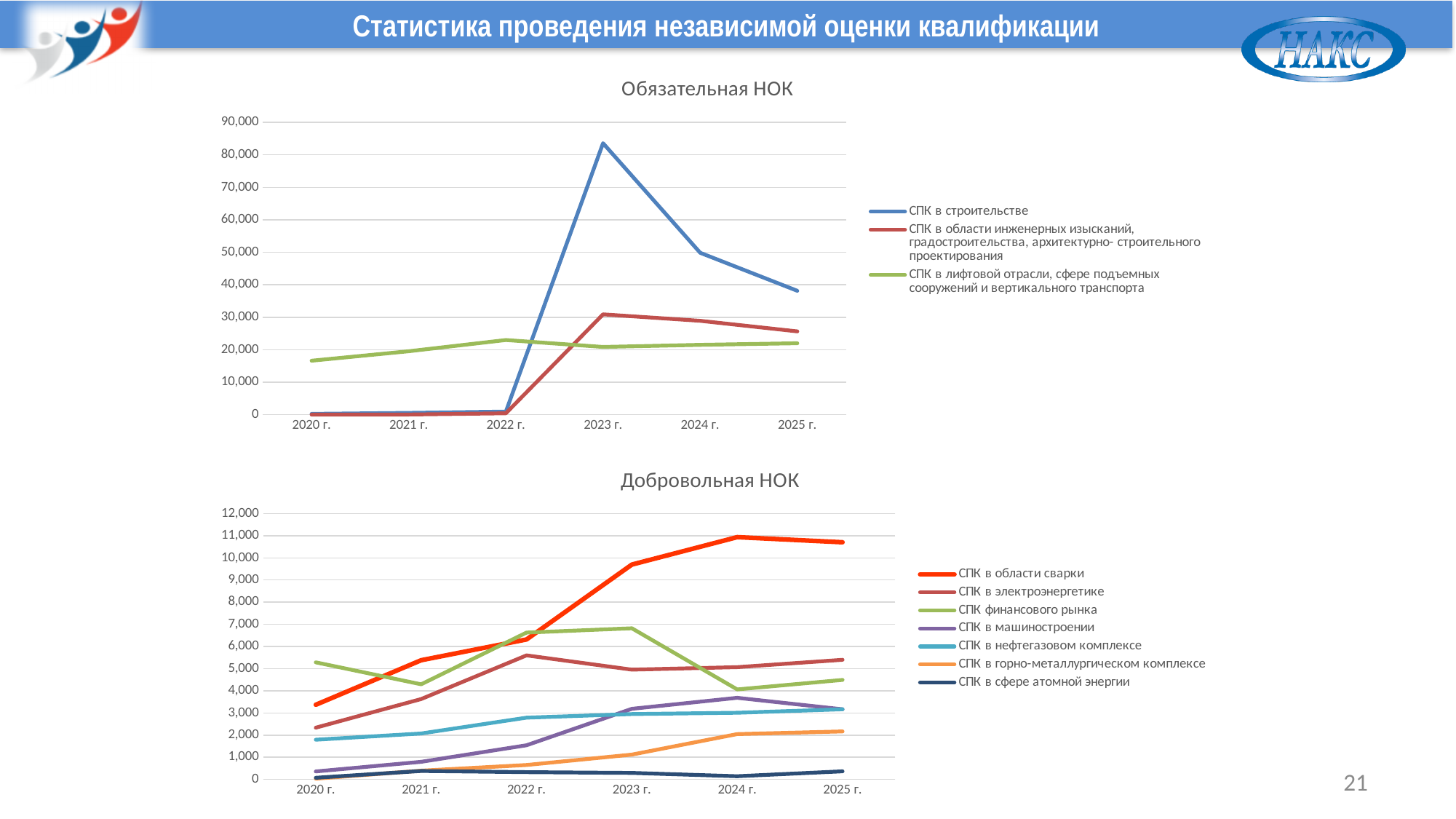
In the "Добровольная НОК" chart, is the value for "СПК в области сварки" in 2024 г. greater or less than 10,000? greater How many years are shown on the x axis of the "Обязательная НОК" chart? 6 In the "Добровольная НОК" chart, which series has the highest value in 2024 г.? СПК в области сварки In the "Обязательная НОК" chart, in which year does the "СПК в строительстве" series reach its highest value? 2023 г. What kind of chart is the "Обязательная НОК" chart? line chart In the "Обязательная НОК" chart, is the value for "СПК в лифтовой отрасли, сфере подъемных сооружений и вертикального транспорта" in 2020 г. greater or less than 20,000? less In the "Обязательная НОК" chart, is the value for "СПК в строительстве" in 2023 г. greater or less than 70,000? greater In the "Добровольная НОК" chart, which series has the lowest value in 2025 г.? СПК в сфере атомной энергии In the "Добровольная НОК" chart, which series is drawn in red? СПК в области сварки How many series does the legend of the "Обязательная НОК" chart list? 3 In the "Обязательная НОК" chart, does the "СПК в строительстве" series rise or fall from 2023 г. to 2025 г.? fall How many series does the legend of the "Добровольная НОК" chart list? 7